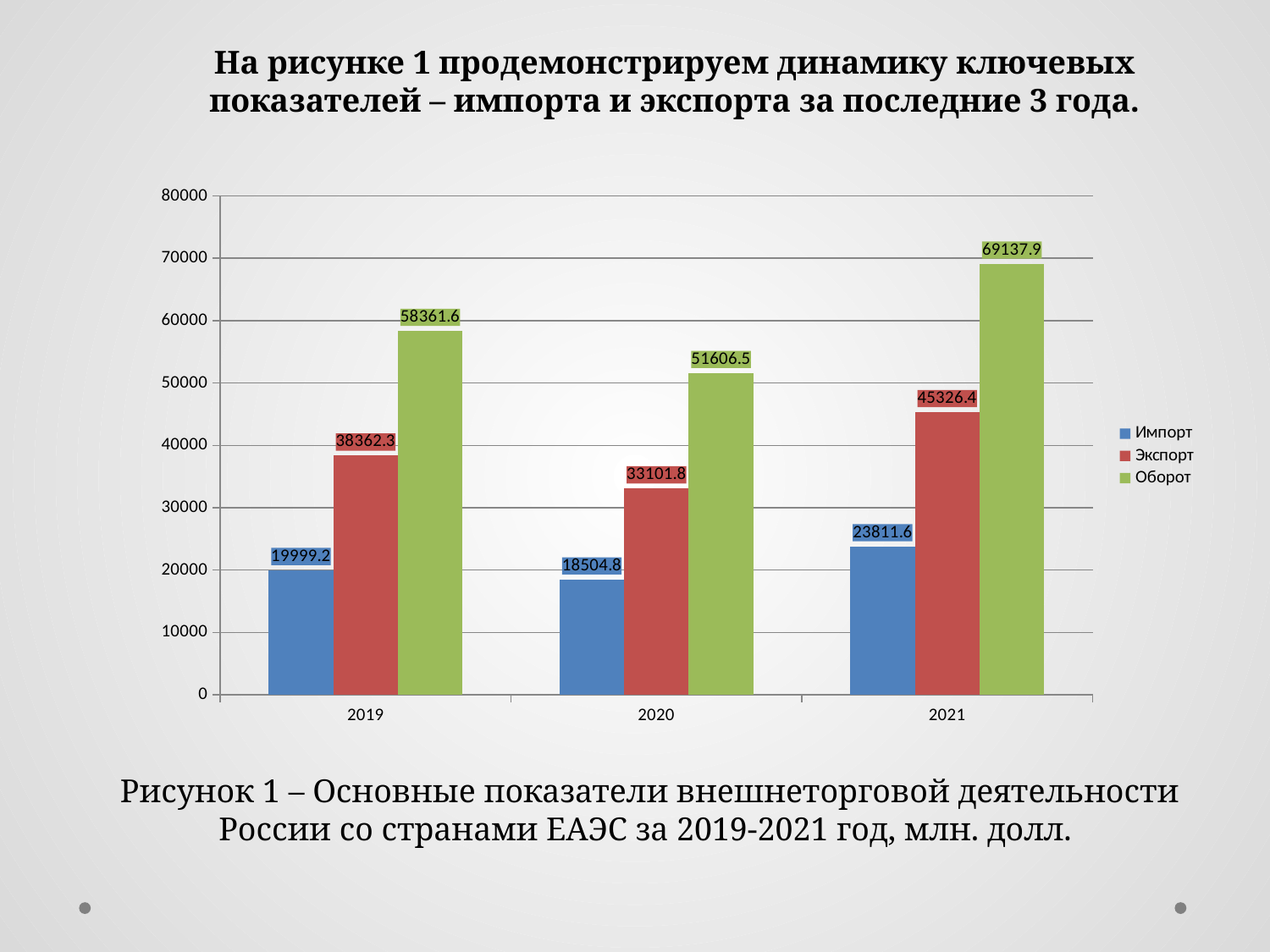
What kind of chart is shown on the slide? bar chart In which year is Импорт the lowest? 2020 What is the value of Экспорт for 2020? 33101.8 What is the difference between Оборот in 2021 and Оборот in 2019? 10776.3 What is the value of Оборот for 2021? 69137.9 Which is larger: Экспорт in 2019 or Экспорт in 2020? Экспорт in 2019 How many series does the legend list? 3 What is the difference between Экспорт in 2021 and Экспорт in 2020? 12224.6 How many years are shown on the x axis? 3 In which year is Оборот the highest? 2021 Is the value of Экспорт for 2021 greater or less than 40000? greater What is the value of Импорт for 2019? 19999.2